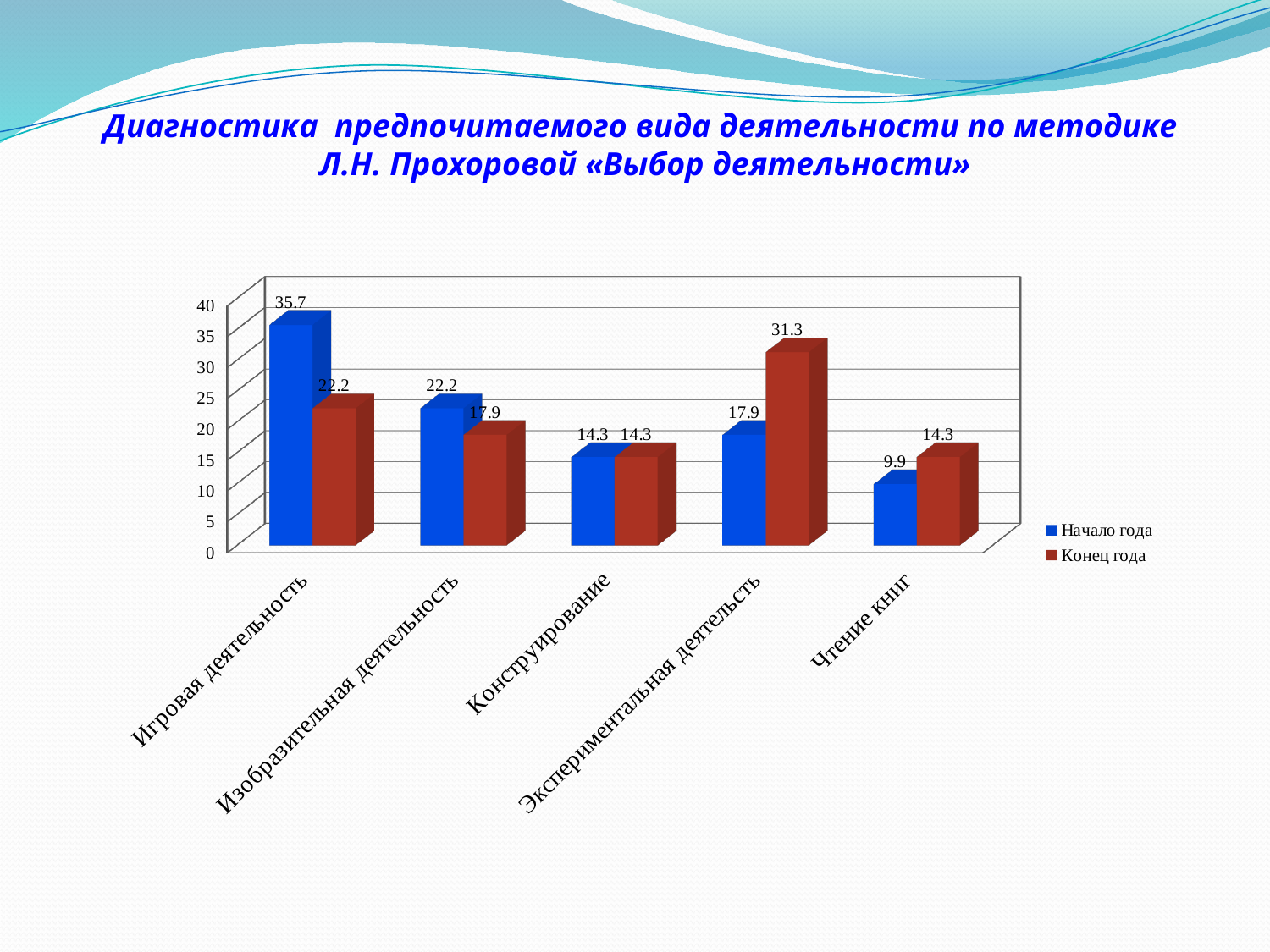
What kind of chart is shown on the slide? bar chart Which colour represents the Конец года series? red How many series does the legend list? 2 What is the value for Чтение книг in the Начало года series? 9.9 What is the difference between the Начало года and Конец года values for Игровая деятельность? 13.5 Which category has the lowest value in the Конец года series? Конструирование and Чтение книг (both 14.3) Is the Конец года value for Изобразительная деятельность greater or less than 20? less Which category has the highest value in the Начало года series? Игровая деятельность Which is larger for Экспериментальная деятельсть: the Начало года value or the Конец года value? Конец года What is the value for Игровая деятельность in the Начало года series? 35.7 What is the value for Экспериментальная деятельсть in the Конец года series? 31.3 How many categories are shown on the x axis? 5